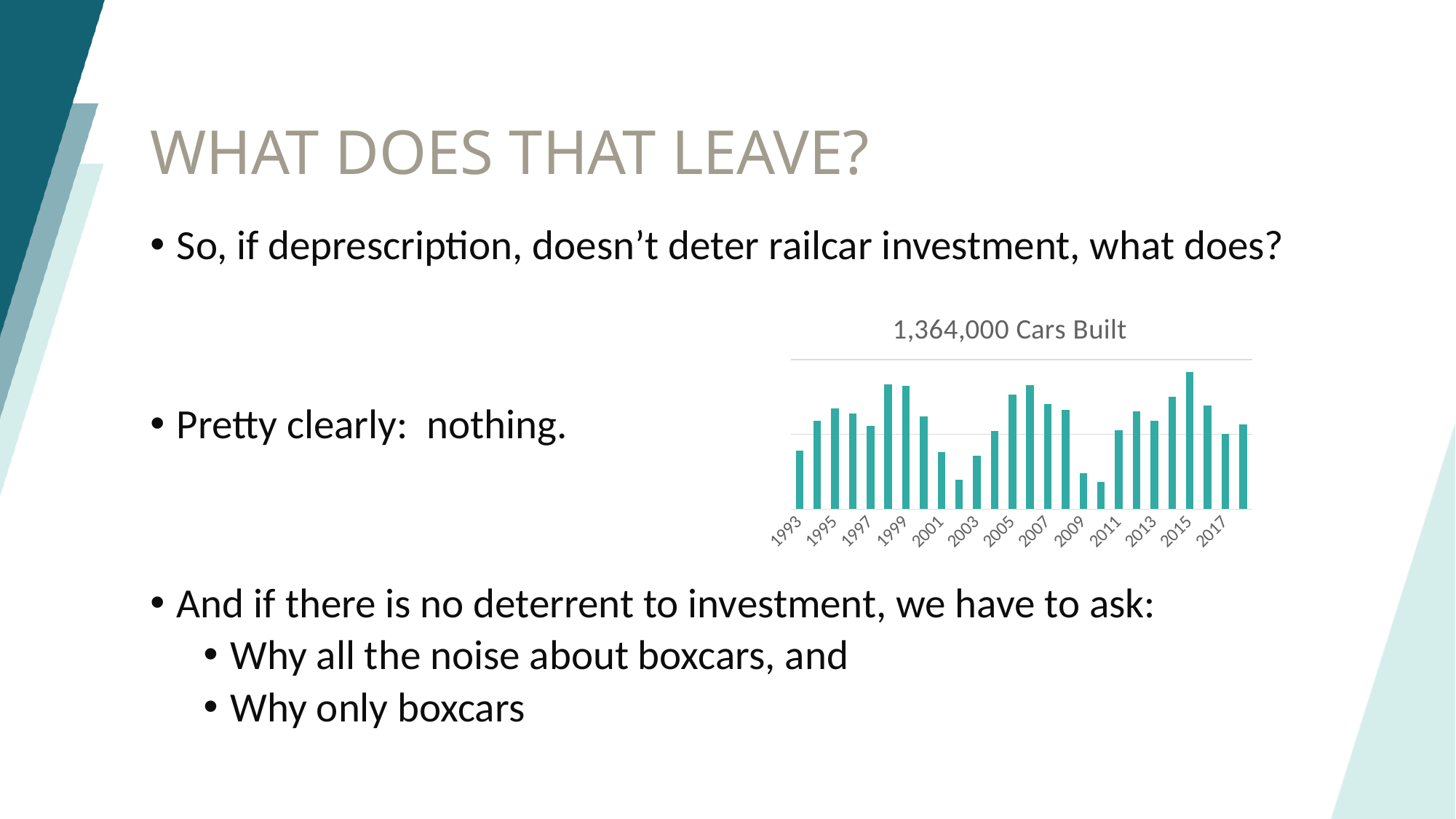
How many bars are plotted in the chart? 26 Which is larger in the chart, the value for 2006 or the value for 2009? 2006 What is the title of the chart? 1,364,000 Cars Built Which is larger in the chart, the value for 2015 or the value for 2010? 2015 Do the values in the chart rise or fall from 2003 to 2006? rise Which is larger in the chart, the value for 1999 or the value for 2003? 1999 Which year has the tallest bar in the chart? 2015 Do the values in the chart rise or fall from 2006 to 2010? fall What kind of chart is shown on the slide? bar chart Do the values in the chart rise or fall from 1999 to 2003? fall What is the first year shown on the x axis of the chart? 1993